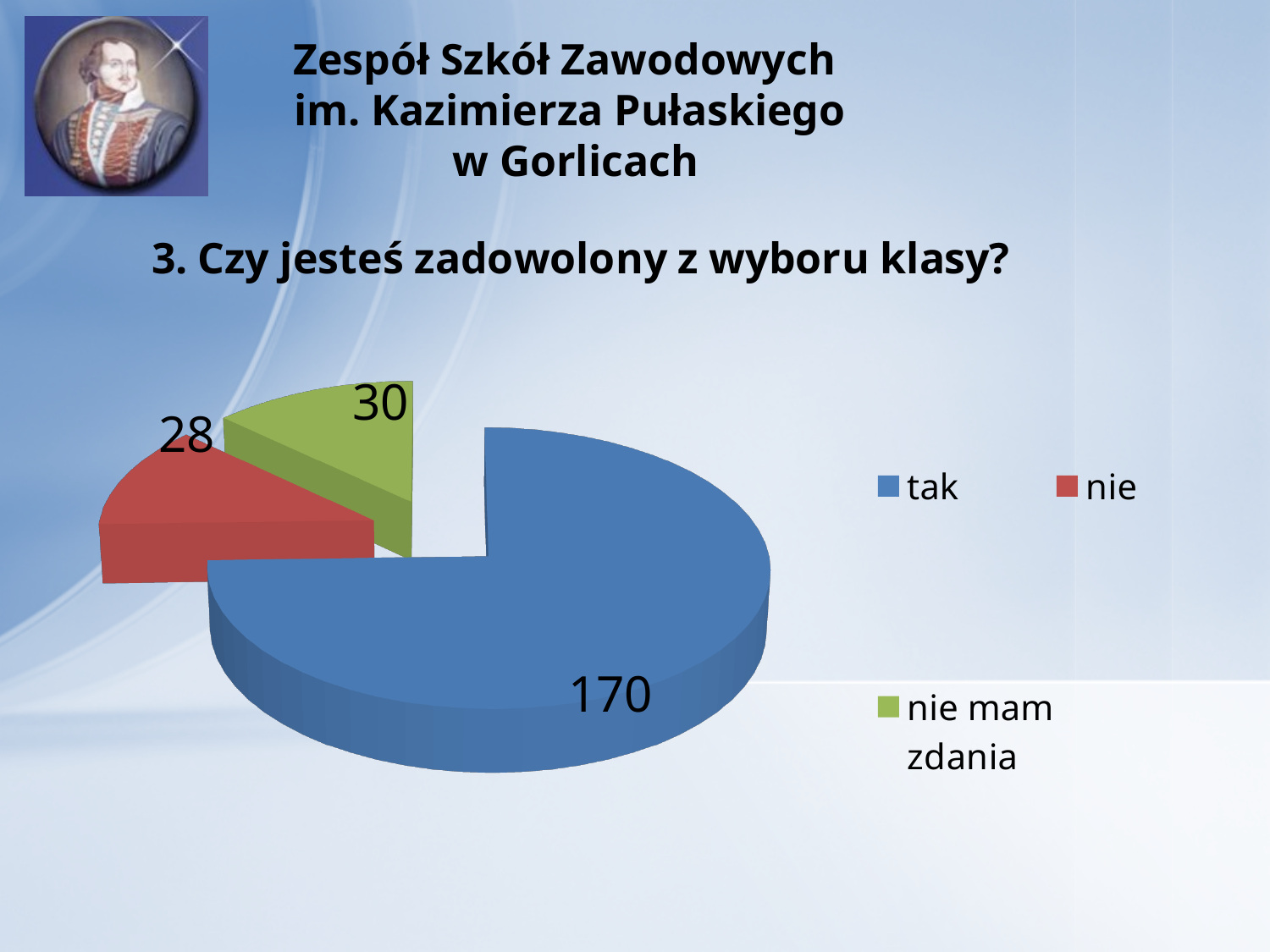
Which category has the smallest slice of the pie? nie How many categories does the pie chart have? 3 Which category has the largest slice of the pie? tak What is the difference between the "nie mam zdania" and "nie" values? 2 Which is larger, the value for "nie" or the value for "nie mam zdania"? nie mam zdania How many responses are shown for "nie mam zdania"? 30 What kind of chart is shown on the slide? pie chart What is the total of all values shown in the pie chart? 228 How many responses are shown for "nie"? 28 How many responses are shown for "tak"? 170 What is the difference between the number of "tak" and "nie" responses? 142 What colour is the slice for "tak"? blue